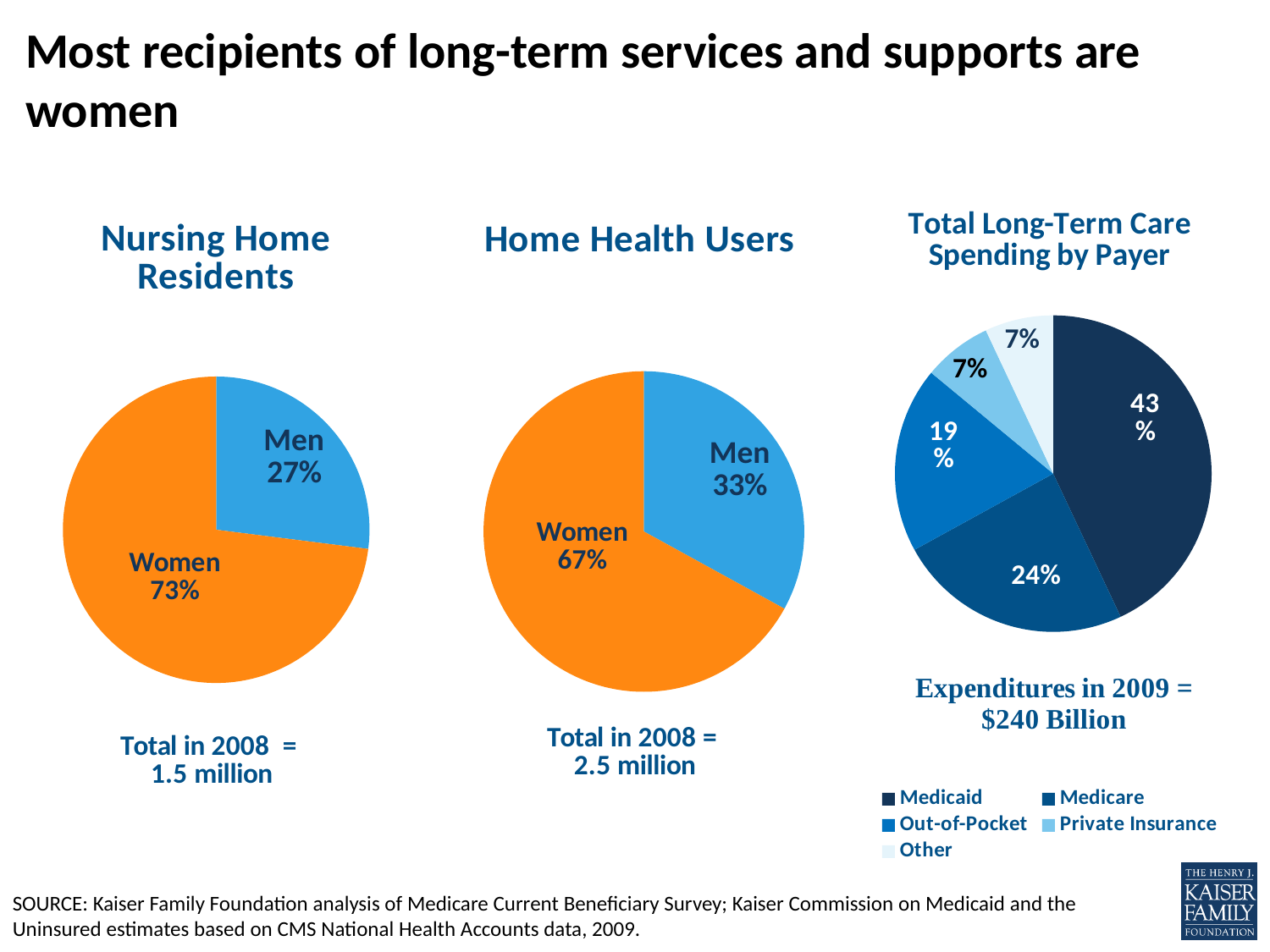
In the Home Health Users chart, what share of users are women? 67% How many payer categories does the legend of the Total Long-Term Care Spending by Payer chart list? 5 What total is shown beneath the Nursing Home Residents chart for 2008? 1.5 million In the Home Health Users chart, what share of users are men? 33% Which is larger: the men's share among Nursing Home Residents or the men's share among Home Health Users? Home Health Users In the Total Long-Term Care Spending by Payer chart, what share of spending comes from Medicaid? 43% In the Nursing Home Residents chart, what share of residents are women? 73% In the Nursing Home Residents chart, what share of residents are men? 27% In the Total Long-Term Care Spending by Payer chart, which payer accounts for the largest share of spending? Medicaid What type of chart is used for Home Health Users? Pie chart In the Nursing Home Residents chart, what is the difference between the women's share and the men's share? 46 percentage points In the Total Long-Term Care Spending by Payer chart, what is the difference between the Medicaid share and the Medicare share? 19 percentage points